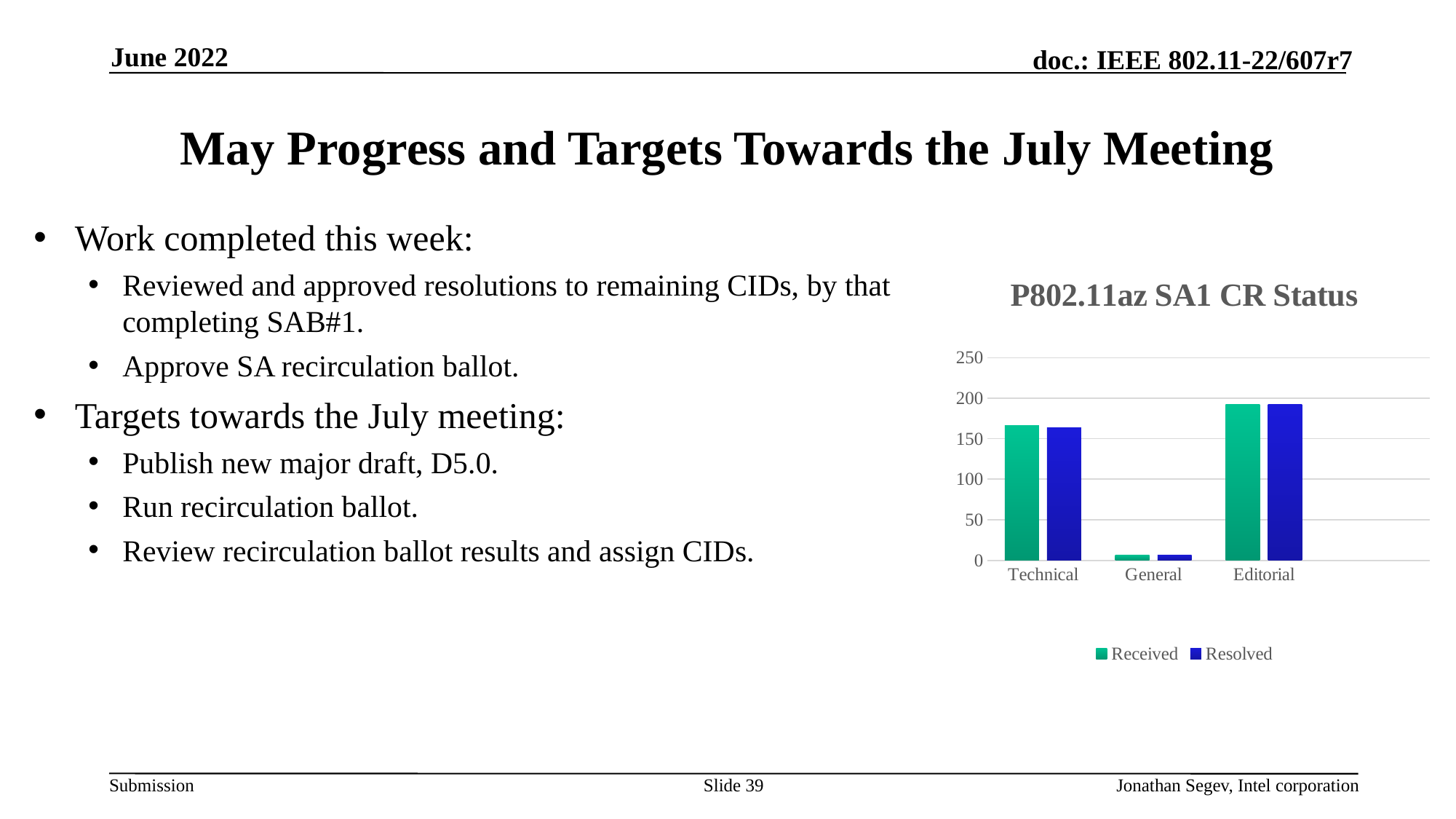
Is the Resolved value for Editorial greater or less than 200? less What kind of chart is shown on the slide? bar chart Is the Received value for General greater or less than 50? less Which is larger, the Received value for Editorial or the Received value for Technical? Editorial Which category has the lowest Resolved value? General Which category has the highest Received value? Editorial Is the Received value for Technical greater or less than 150? greater How many categories are shown on the x axis of the chart? 3 What is the title of the chart? P802.11az SA1 CR Status How many series does the chart's legend list? 2 Which is larger, the Resolved value for Technical or the Resolved value for General? Technical Which series is shown in green in the chart? Received